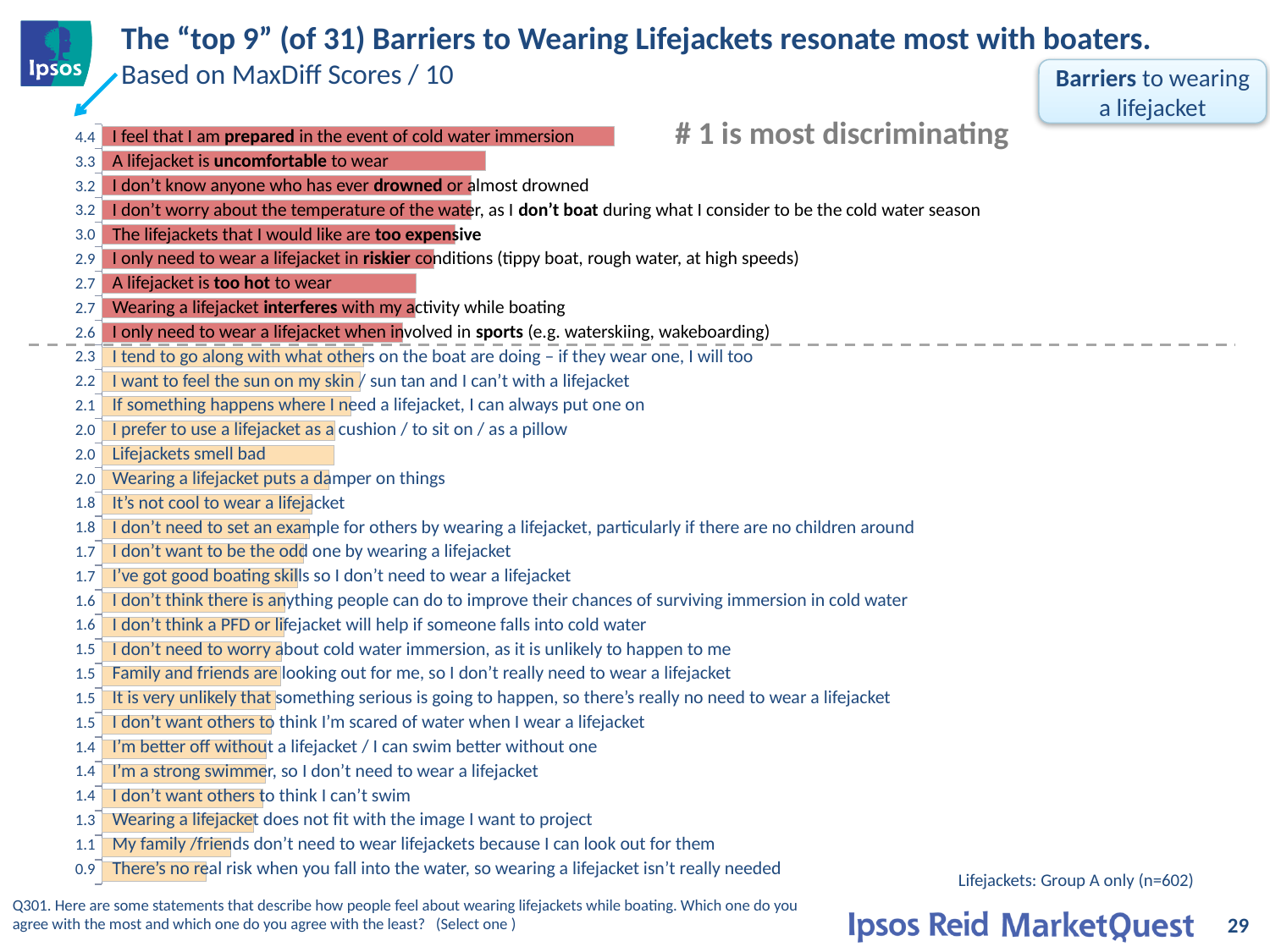
How many bars are highlighted in red above the dashed line? 9 What is the MaxDiff score for "The lifejackets that I would like are too expensive"? 3.0 What is the difference between the MaxDiff scores of "I only need to wear a lifejacket when involved in sports" and "I tend to go along with what others on the boat are doing"? 0.3 What is the MaxDiff score for "A lifejacket is uncomfortable to wear"? 3.3 Which barrier has the lowest MaxDiff score? There's no real risk when you fall into the water, so wearing a lifejacket isn't really needed How many barrier statements are plotted in the chart? 31 What is the MaxDiff score for "My family /friends don't need to wear lifejackets because I can look out for them"? 1.1 What type of chart is shown on the slide? Bar chart Which has a higher MaxDiff score: "A lifejacket is too hot to wear" or "It's not cool to wear a lifejacket"? A lifejacket is too hot to wear Which barrier has the highest MaxDiff score? I feel that I am prepared in the event of cold water immersion What is the difference between the MaxDiff scores of "I feel that I am prepared in the event of cold water immersion" and "A lifejacket is uncomfortable to wear"? 1.1 What is the MaxDiff score for "Lifejackets smell bad"? 2.0